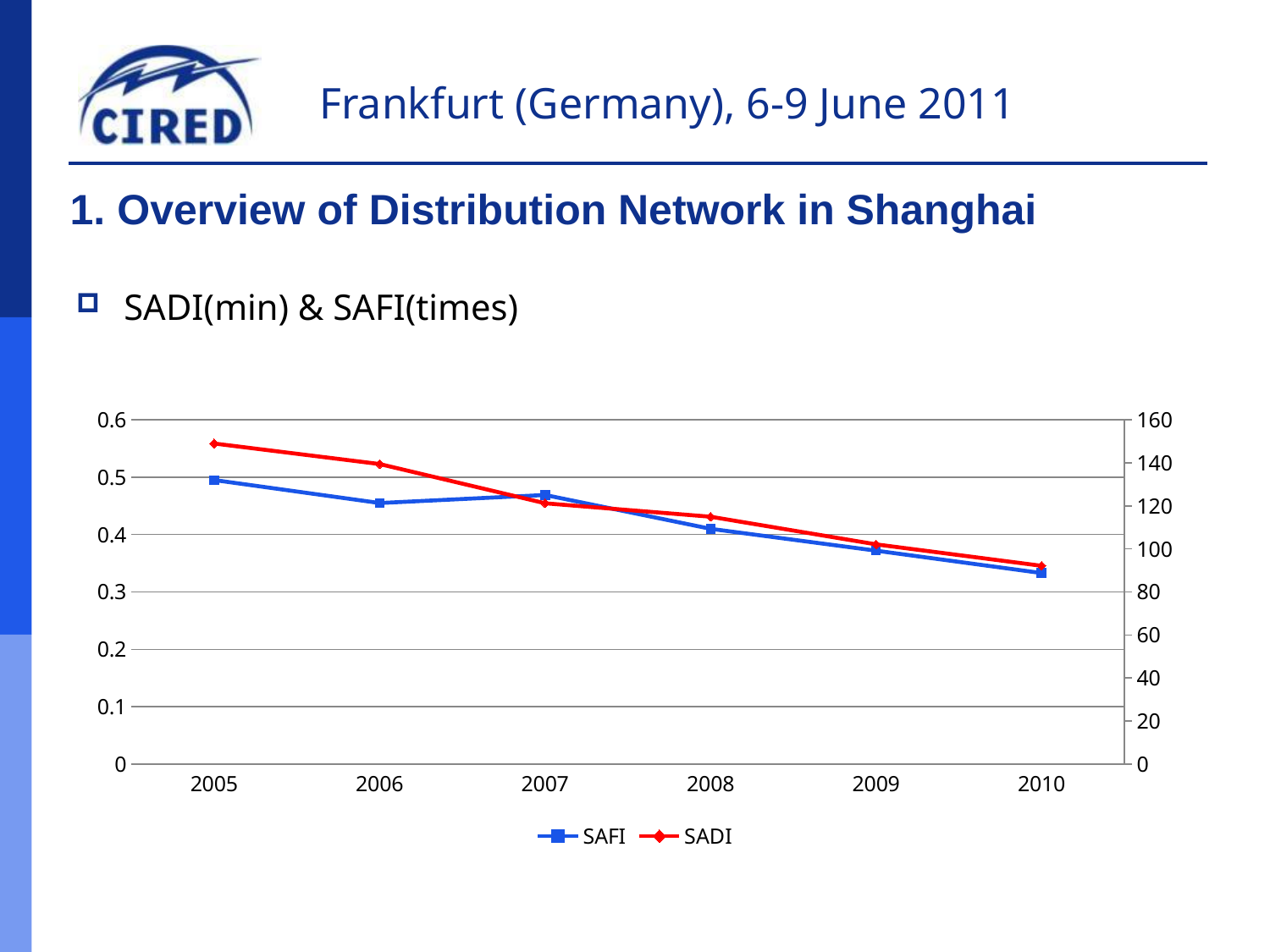
Is the SADI value for 2010 greater or less than 100 on the right axis? less Do the SADI values rise or fall from 2005 to 2010? fall In which year is the SAFI value lowest? 2010 What kind of chart is shown on the slide? line chart Is the SAFI value for 2006 greater or less than 0.4? greater In which year is the SADI value highest? 2005 Is the SAFI value for 2009 greater or less than 0.4? less Which is larger, the SAFI value for 2005 or the SAFI value for 2010? 2005 How many series does the legend list? 2 Which series is drawn in red? SADI How many years are plotted along the x axis? 6